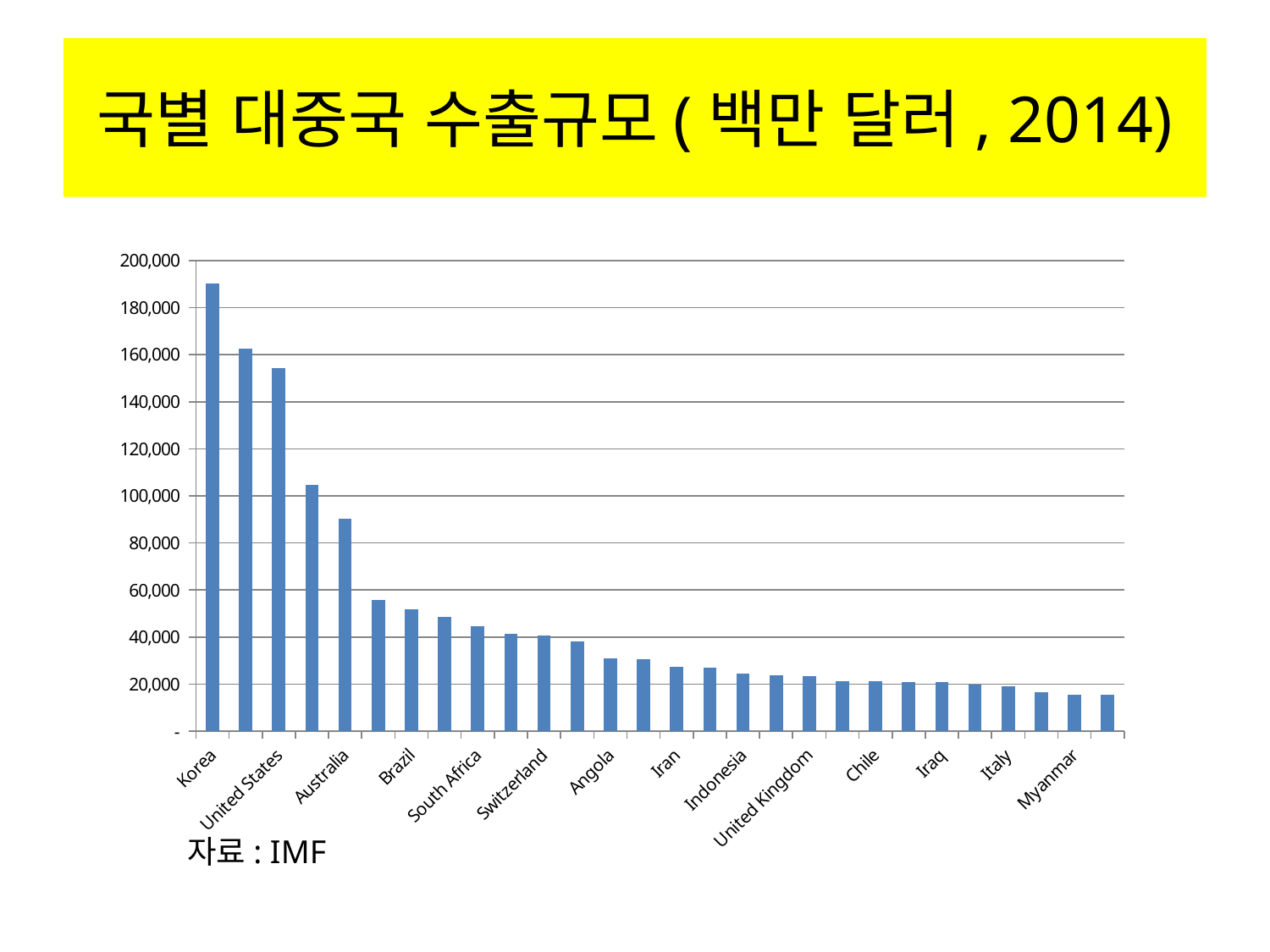
Which is larger, the value for Korea or the value for United States? Korea Which is larger, the value for Australia or the value for Brazil? Australia Is the value for Brazil greater or less than 40,000? greater Is the value for Switzerland greater or less than 60,000? less What kind of chart is shown on the slide? bar chart Is the value for United States greater or less than 140,000? greater Do the values rise or fall moving from left to right along the x axis? fall Which country has the highest value in the chart? Korea